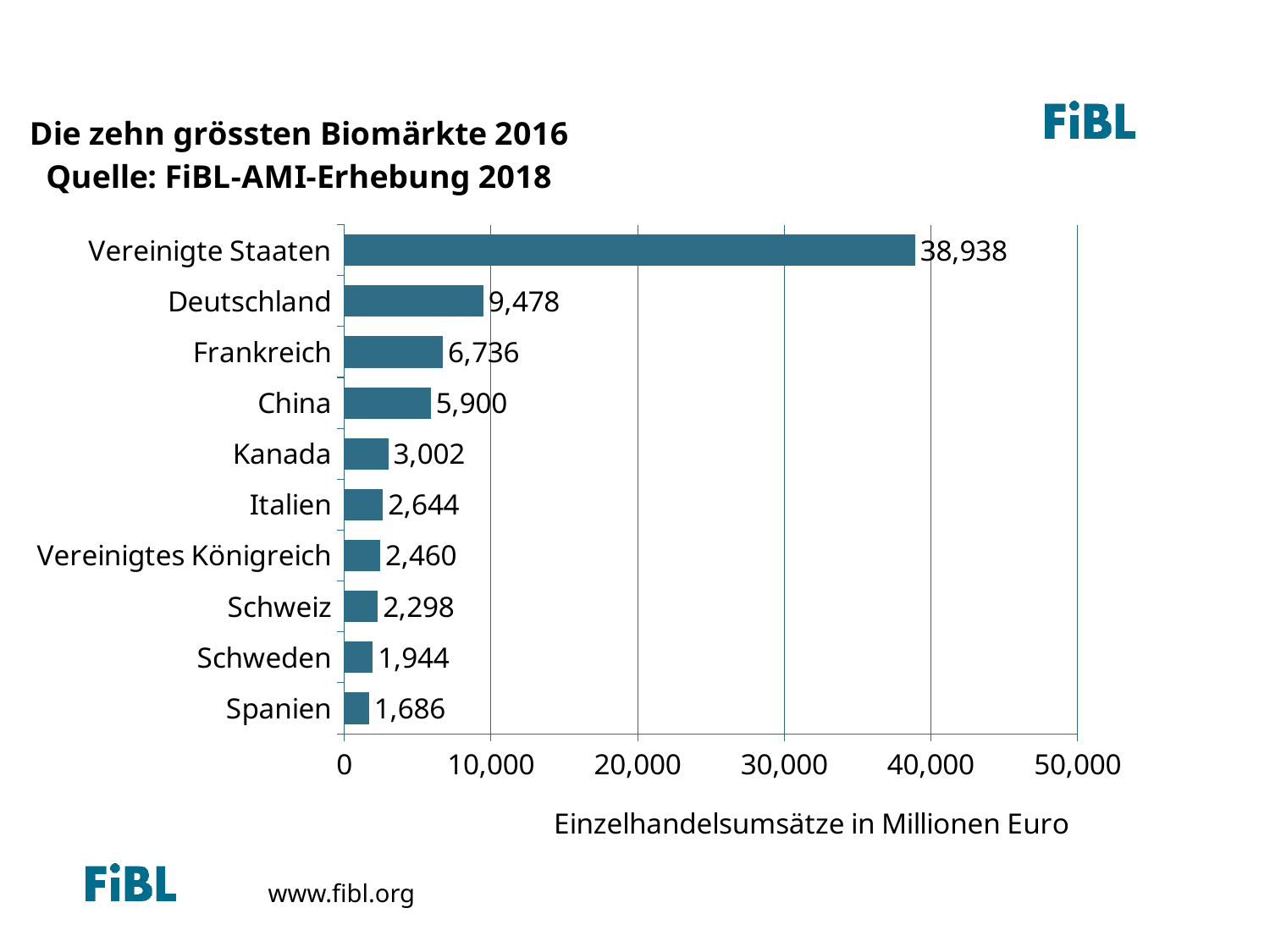
What is the difference between the values for Frankreich and China? 836 What is the label of the horizontal axis? Einzelhandelsumsätze in Millionen Euro Which country has the highest value? Vereinigte Staaten What is the difference between the values for Vereinigte Staaten and Deutschland? 29,460 Is the value for Vereinigte Staaten greater or less than 40,000? less What kind of chart is shown on the slide? bar chart What is the value for Kanada? 3,002 How many countries are shown in the chart? 10 Which is larger, the value for Italien or the value for Schweden? Italien Which country has the lowest value? Spanien What is the value for Deutschland? 9,478 What is the value for Schweiz? 2,298